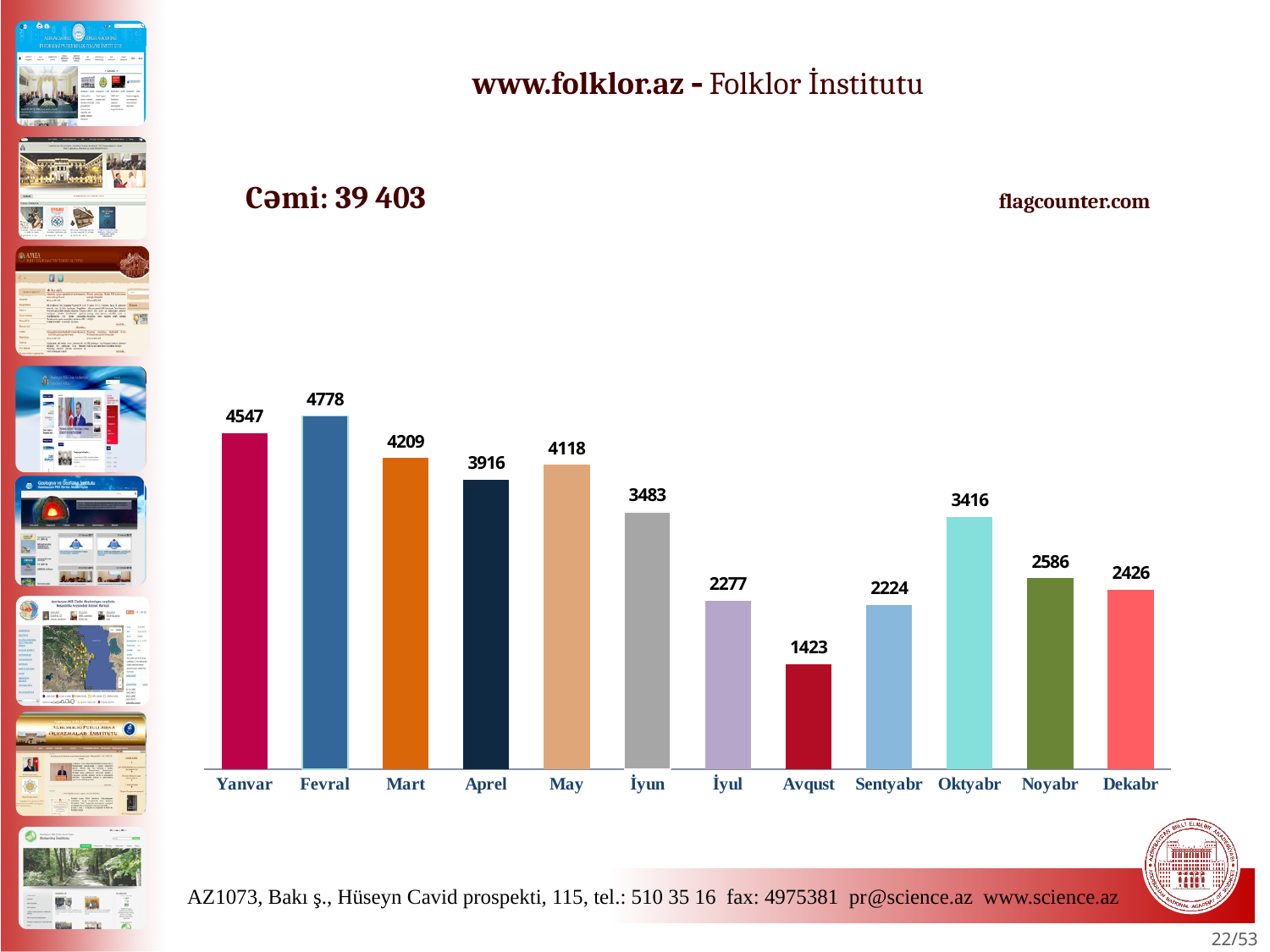
What is the value for Oktyabr? 3416 How many months are shown on the chart? 12 Do the values rise or fall from Iyun to Avqust? fall What total (Cəmi) is stated on the slide? 39 403 What is the difference between the values for Yanvar and Dekabr? 2121 What website is the chart about, according to the title? www.folklor.az Which month has the highest value? Fevral Which month has the lowest value? Avqust What is the value for Fevral? 4778 Which is larger, the value for Mart or the value for May? Mart What kind of chart is shown on the slide? bar chart What is the value for Avqust? 1423